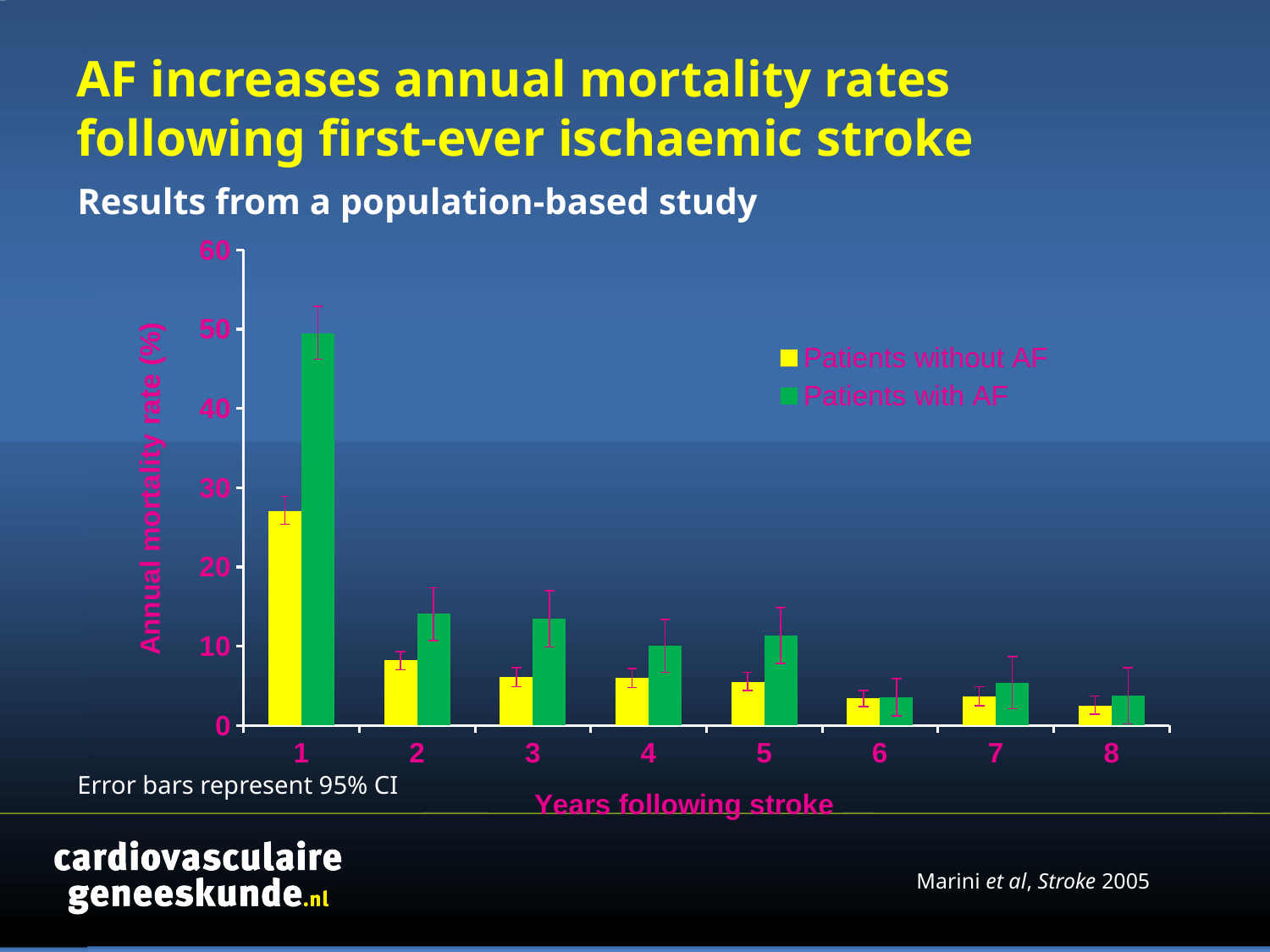
In which year following stroke is the annual mortality rate for Patients without AF highest? 1 What kind of chart is shown on the slide? bar chart In year 3 following stroke, which group has the higher annual mortality rate, Patients with AF or Patients without AF? Patients with AF How many series does the legend list? 2 What colour represents Patients with AF in the chart? green In which year following stroke is the annual mortality rate for Patients without AF lowest? 8 Does the annual mortality rate for Patients with AF generally rise or fall as the years following stroke increase? fall Is the annual mortality rate for Patients with AF in year 2 greater or less than 20? less Is the annual mortality rate for Patients without AF in year 1 greater or less than 20? greater Is the annual mortality rate for Patients with AF in year 1 greater or less than 40? greater How many years following stroke are shown on the x axis? 8 In which year following stroke is the annual mortality rate for Patients with AF highest? 1